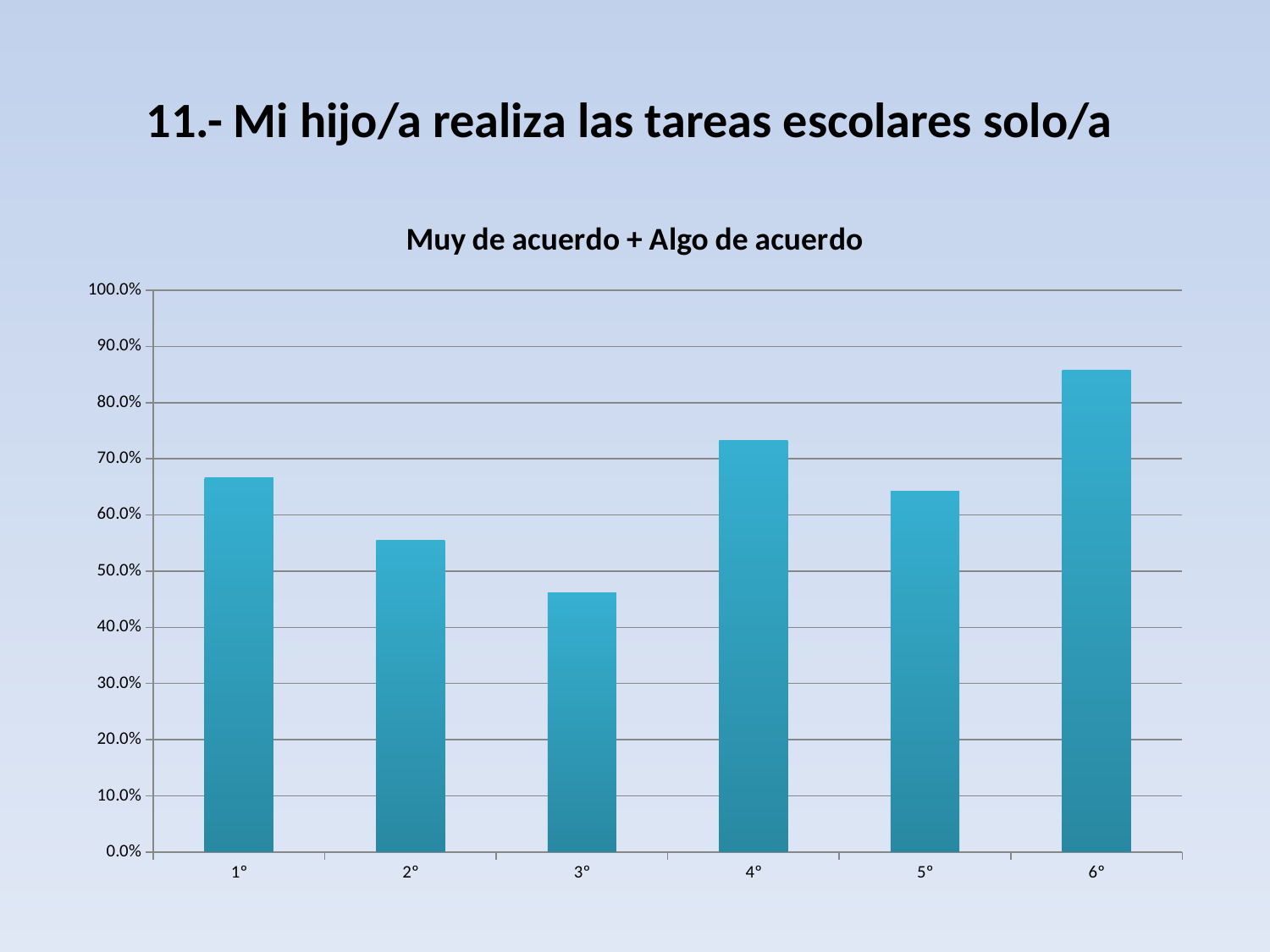
How many categories are shown on the x axis of the chart? 6 Is the value for 6° greater or less than 80.0%? greater Is the value for 4° greater or less than 70.0%? greater Which category has the lowest value in the chart? 3° Which category has the highest value in the chart? 6° Do the values rise or fall from 1° to 3°? fall What kind of chart is shown on the slide? bar chart What is the title of the chart? Muy de acuerdo + Algo de acuerdo Which is larger, the value for 4° or the value for 2°? 4° Is the value for 1° greater or less than 60.0%? greater